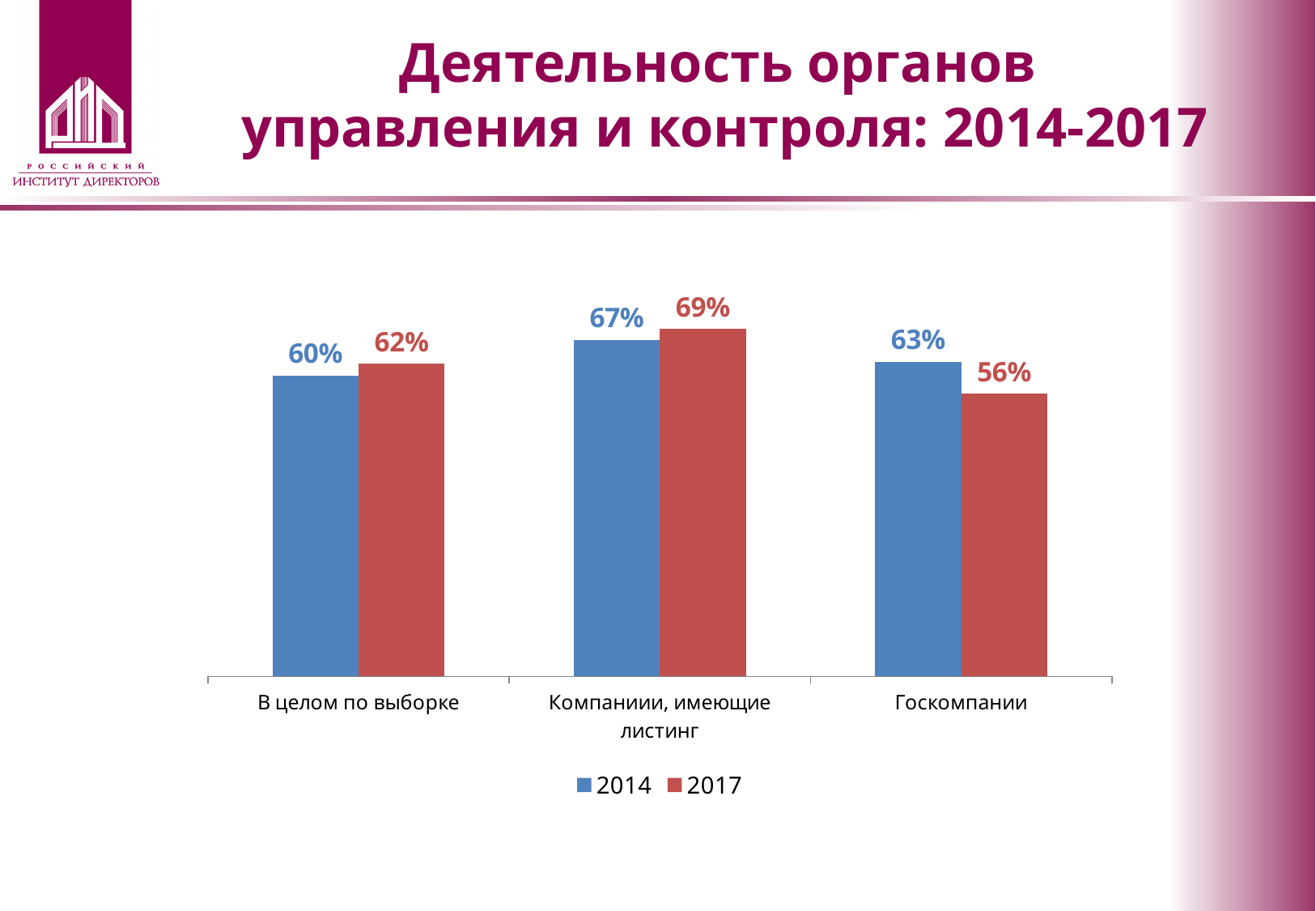
What is the 2017 value for Госкомпании? 56% What kind of chart is shown on the slide? Bar chart What is the 2014 value for Госкомпании? 63% What is the 2014 value for В целом по выборке? 60% Which is larger for В целом по выборке, the 2014 value or the 2017 value? 2017 What is the difference between the 2014 and 2017 values for Госкомпании? 7% How many series does the legend list? 2 What is the 2017 value for Компаниии, имеющие листинг? 69% Which category has the lowest 2017 value? Госкомпании Which colour represents the 2017 series in the legend? Red Which category has the highest 2017 value? Компаниии, имеющие листинг How many categories are shown on the x axis? 3